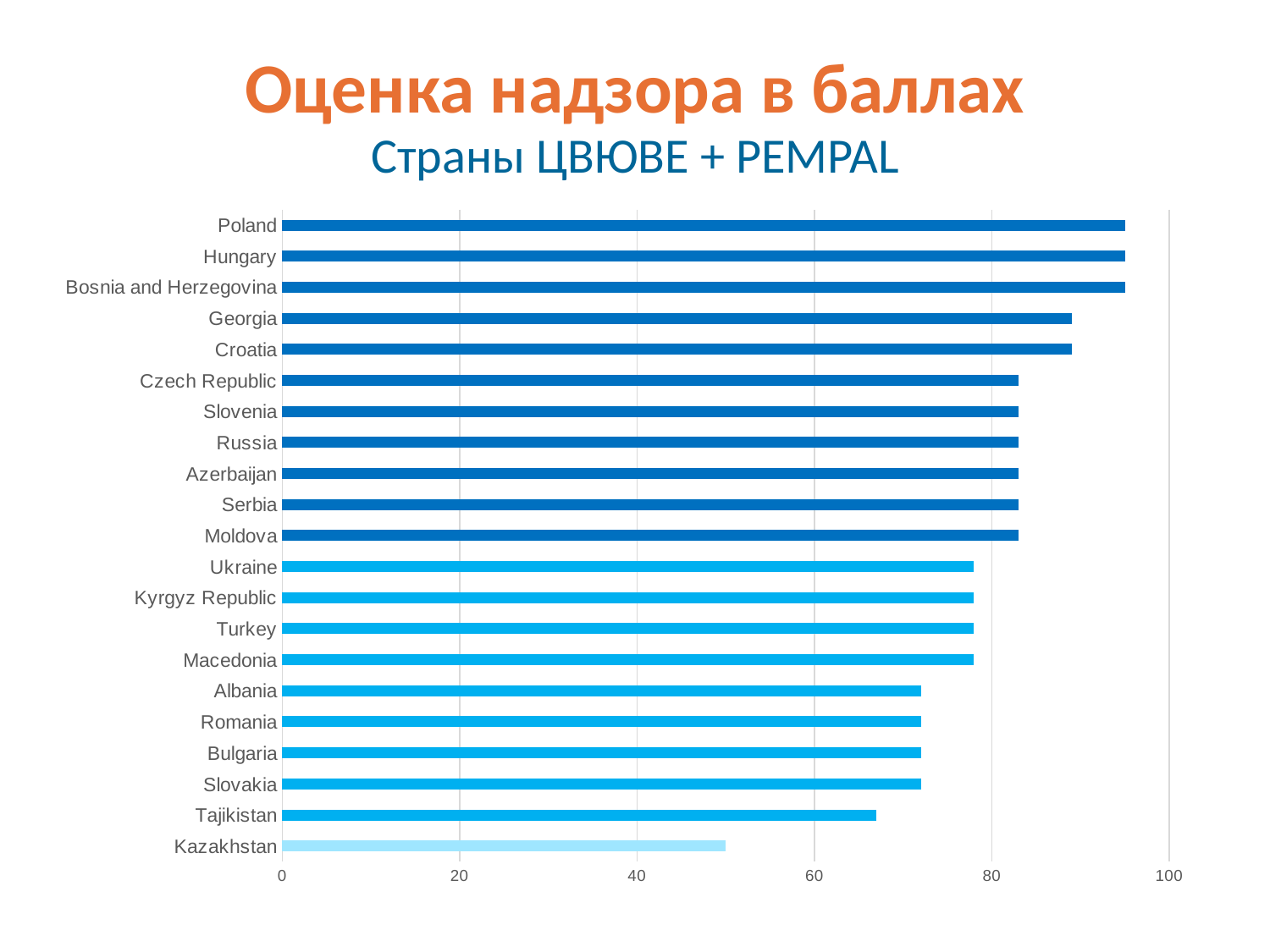
What kind of chart is shown on the slide? bar chart Which country has the lowest score on the chart? Kazakhstan Is the value for Georgia greater or less than 80? greater Is the value for Ukraine greater or less than 80? less Which has a higher score, Moldova or Ukraine? Moldova Is the value for Tajikistan greater or less than 60? greater Do the bar values rise or fall going from the top of the chart to the bottom? fall Which has a higher score, Georgia or Kazakhstan? Georgia How many countries are listed on the chart? 21 What is the main title of the slide? Оценка надзора в баллах